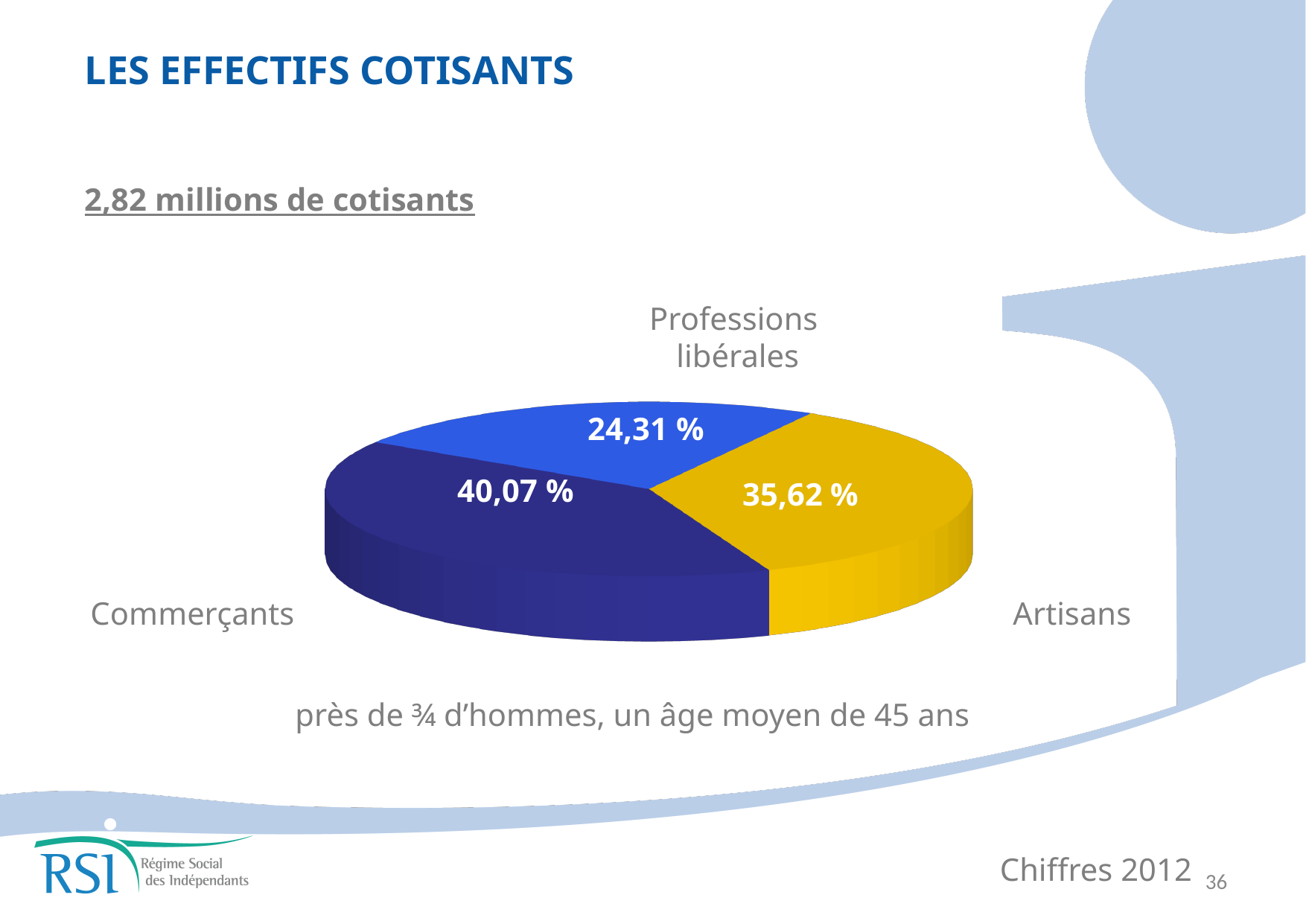
What is the difference in percentage points between Artisans and Professions libérales? 11,31 What share of the pie is Artisans? 35,62 % What colour is the Artisans slice? yellow What share of the pie is Professions libérales? 24,31 % What share of the pie is Commerçants? 40,07 % What kind of chart is shown on the slide? pie chart What is the difference in percentage points between Commerçants and Artisans? 4,45 Which category has the smallest slice of the pie? Professions libérales Which is larger, the share for Artisans or the share for Professions libérales? Artisans What total number of contributors is stated above the chart? 2,82 millions de cotisants How many slices does the pie chart have? 3 Which category has the largest slice of the pie? Commerçants